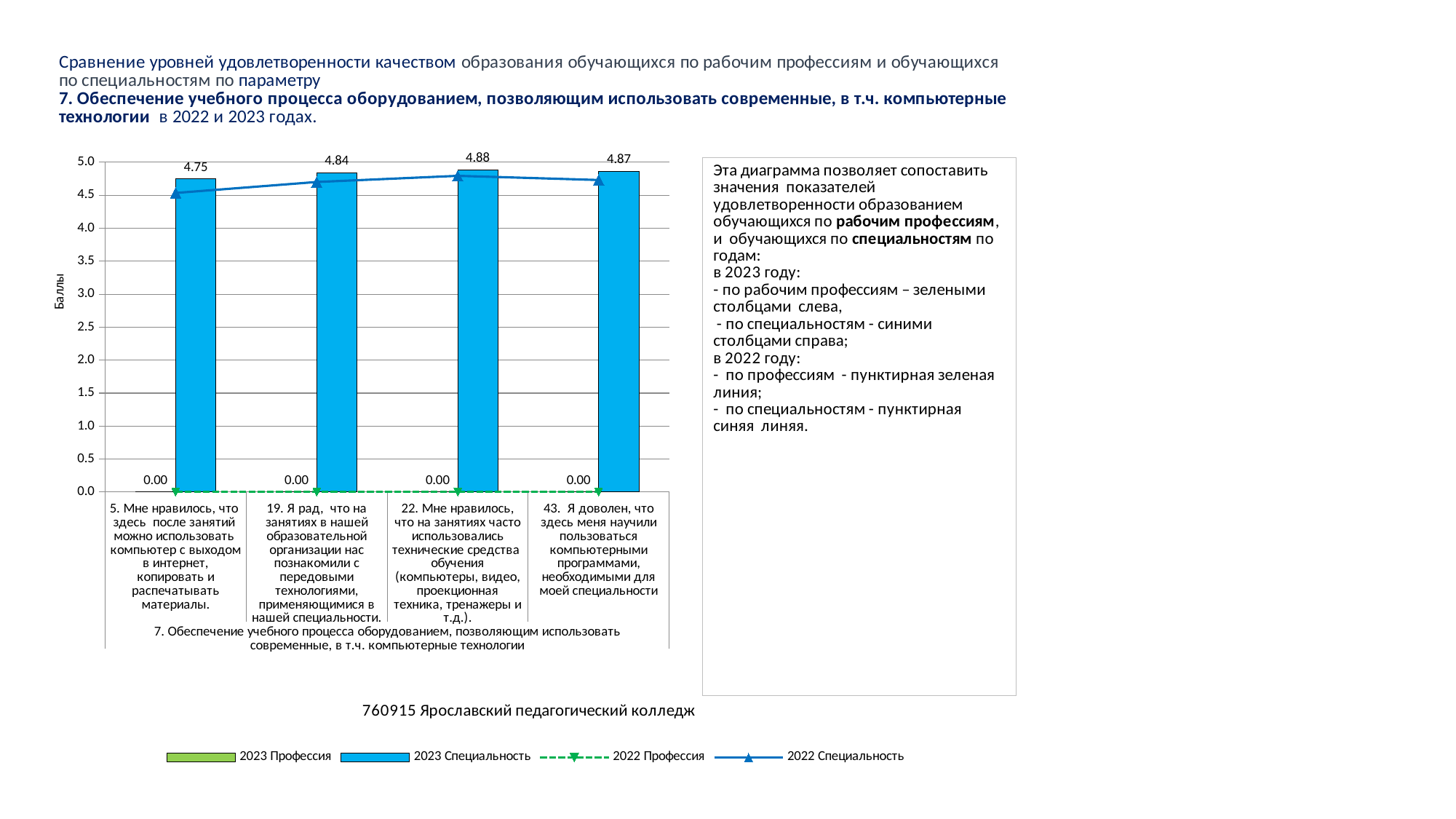
What is the difference between the 2023 Специальность values for category 22 and category 5? 0.13 What value is labelled for the 2023 Профессия series in each category? 0.00 Is the 2022 Специальность value for category 5 greater or less than 4.0? greater Which is larger: the 2023 Специальность value for category 19 or for category 5? Category 19 (4.84) What is the value of the 2023 Специальность bar for category 43 ("Я доволен, что здесь меня научили пользоваться компьютерными программами...")? 4.87 Which category has the lowest 2023 Специальность value? 5. Мне нравилось, что здесь после занятий можно использовать компьютер с выходом в интернет How many categories are shown on the x axis? 4 How many series does the legend list? 4 What is the value of the 2023 Специальность bar for category 22 ("Мне нравилось, что на занятиях часто использовались технические средства обучения...")? 4.88 What is the label of the vertical axis? Баллы What is the value of the 2023 Специальность bar for category 5 ("Мне нравилось, что здесь после занятий можно использовать компьютер с выходом в интернет...")? 4.75 Which category has the highest 2023 Специальность value? 22. Мне нравилось, что на занятиях часто использовались технические средства обучения